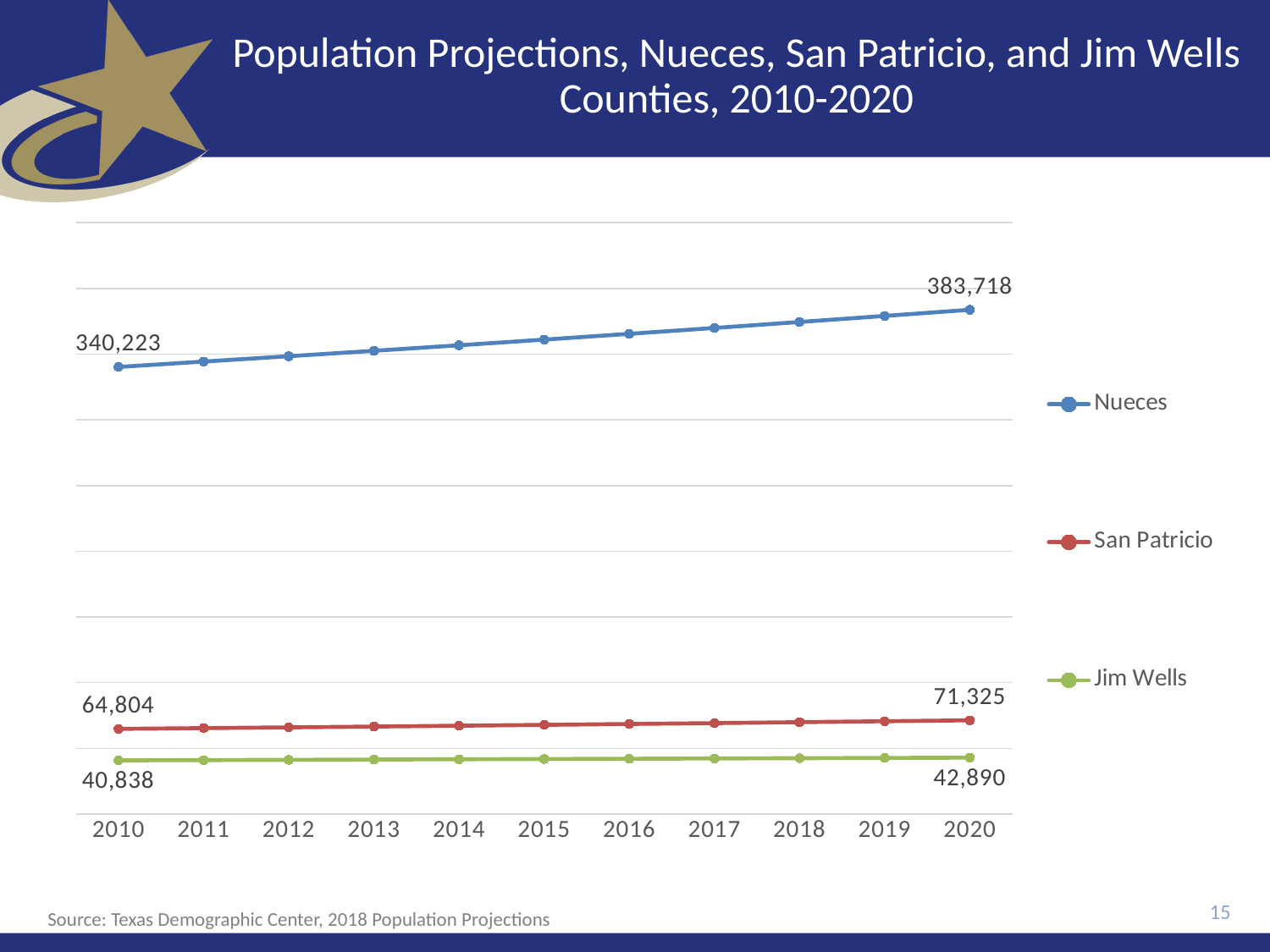
How many series does the legend list? 3 By how much is San Patricio County's population projected to grow from 2010 to 2020? 6,521 What is the projected population of San Patricio County in 2020? 71,325 What is the projected population of San Patricio County in 2010? 64,804 What kind of chart is shown on the slide? Line chart What is the projected population of Jim Wells County in 2020? 42,890 What is the projected population of Nueces County in 2010? 340,223 What is the projected population of Jim Wells County in 2010? 40,838 By how much is Nueces County's population projected to grow from 2010 to 2020? 43,495 What is the projected population of Nueces County in 2020? 383,718 Which county has the lowest projected population in 2010? Jim Wells Which county has the highest projected population in 2020? Nueces